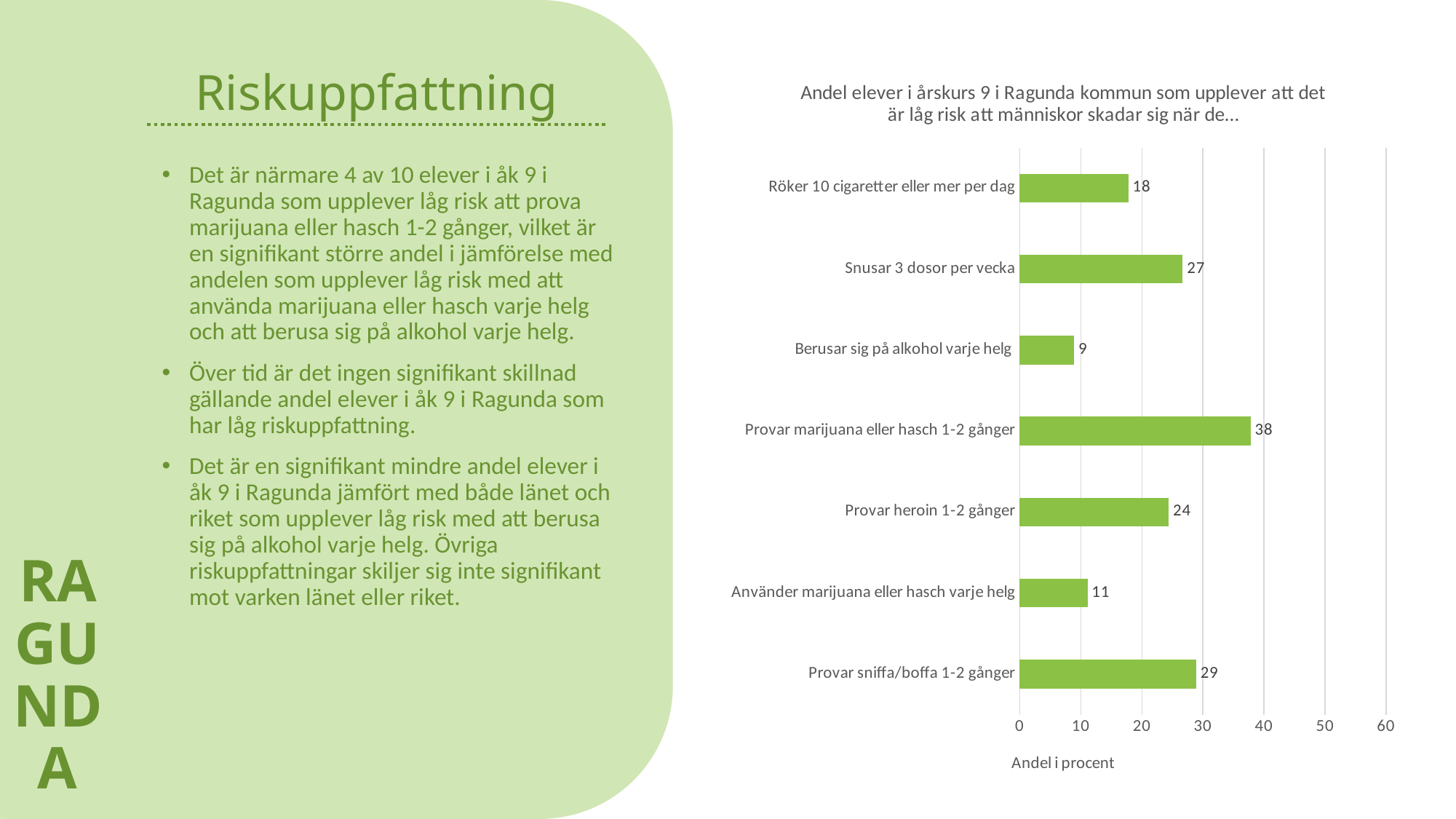
What is the value for "Provar marijuana eller hasch 1-2 gånger"? 38 Which is larger: the value for "Röker 10 cigaretter eller mer per dag" or "Använder marijuana eller hasch varje helg"? Röker 10 cigaretter eller mer per dag Is the value for "Provar heroin 1-2 gånger" greater or less than 20? greater What kind of chart is shown on the slide? Bar chart Which category has the highest value? Provar marijuana eller hasch 1-2 gånger What is the label of the horizontal axis? Andel i procent What is the difference between the values for "Provar sniffa/boffa 1-2 gånger" and "Provar heroin 1-2 gånger"? 5 What is the value for "Berusar sig på alkohol varje helg"? 9 How many categories are shown in the chart? 7 Which category has the lowest value? Berusar sig på alkohol varje helg What is the highest tick value shown on the horizontal axis? 60 What is the value for "Snusar 3 dosor per vecka"? 27